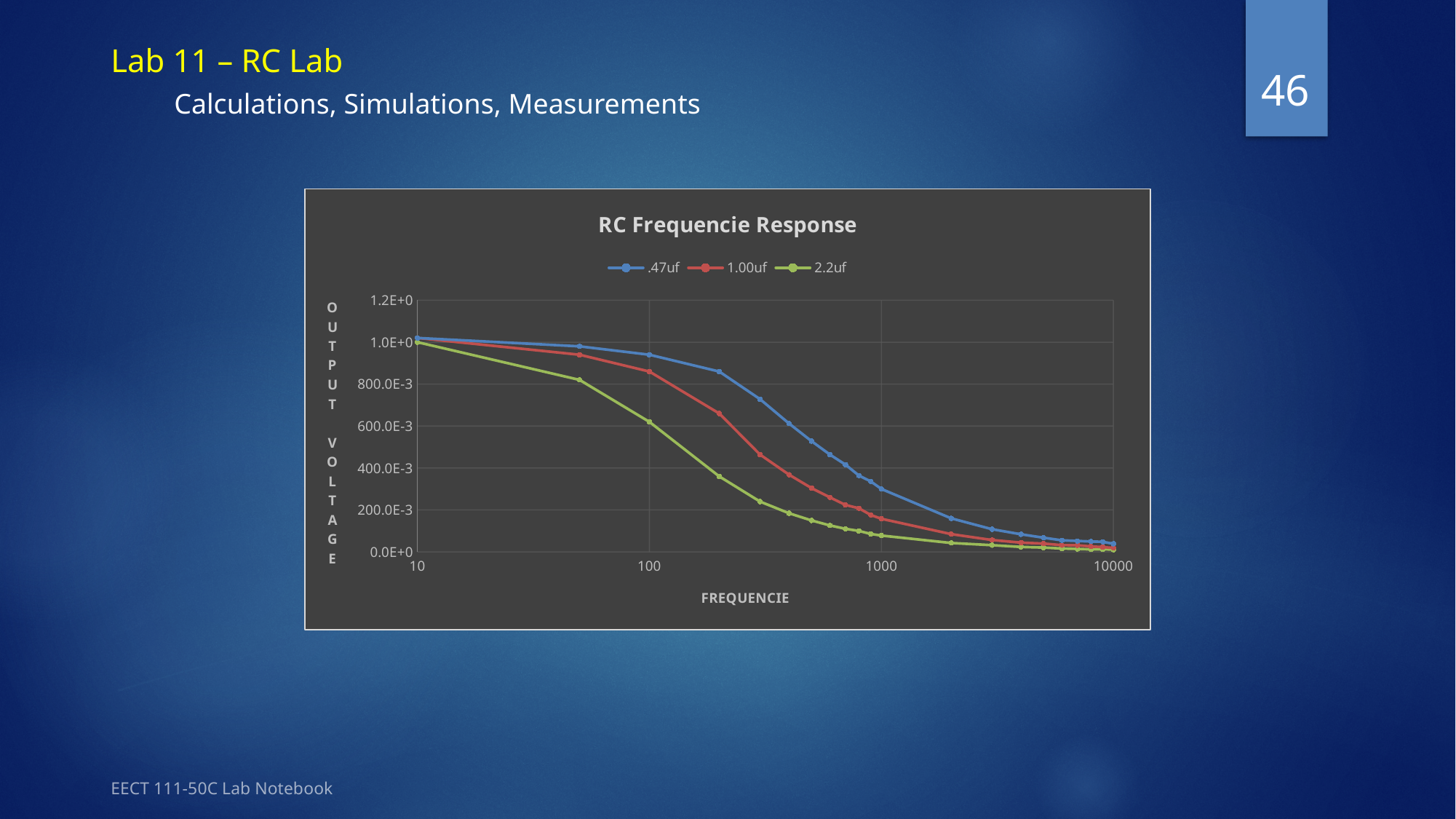
Which series has the lowest output voltage at a frequency of 1000? 2.2uf How many series does the legend of the RC Frequencie Response chart list? 3 Which series has the highest output voltage at a frequency of 1000? .47uf What is the title of the chart? RC Frequencie Response Do the output voltage values rise or fall as frequency increases along the x axis? fall Is the value for the 1.00uf series at a frequency of 1000 greater or less than 200.0E-3? less What is the label of the x axis? FREQUENCIE Is the value for the 2.2uf series at a frequency of 100 greater or less than 800.0E-3? less At a frequency of 100, which series has the larger output voltage, .47uf or 2.2uf? .47uf What kind of chart is shown on the slide? line chart Is the value for the .47uf series at a frequency of 100 greater or less than 800.0E-3? greater